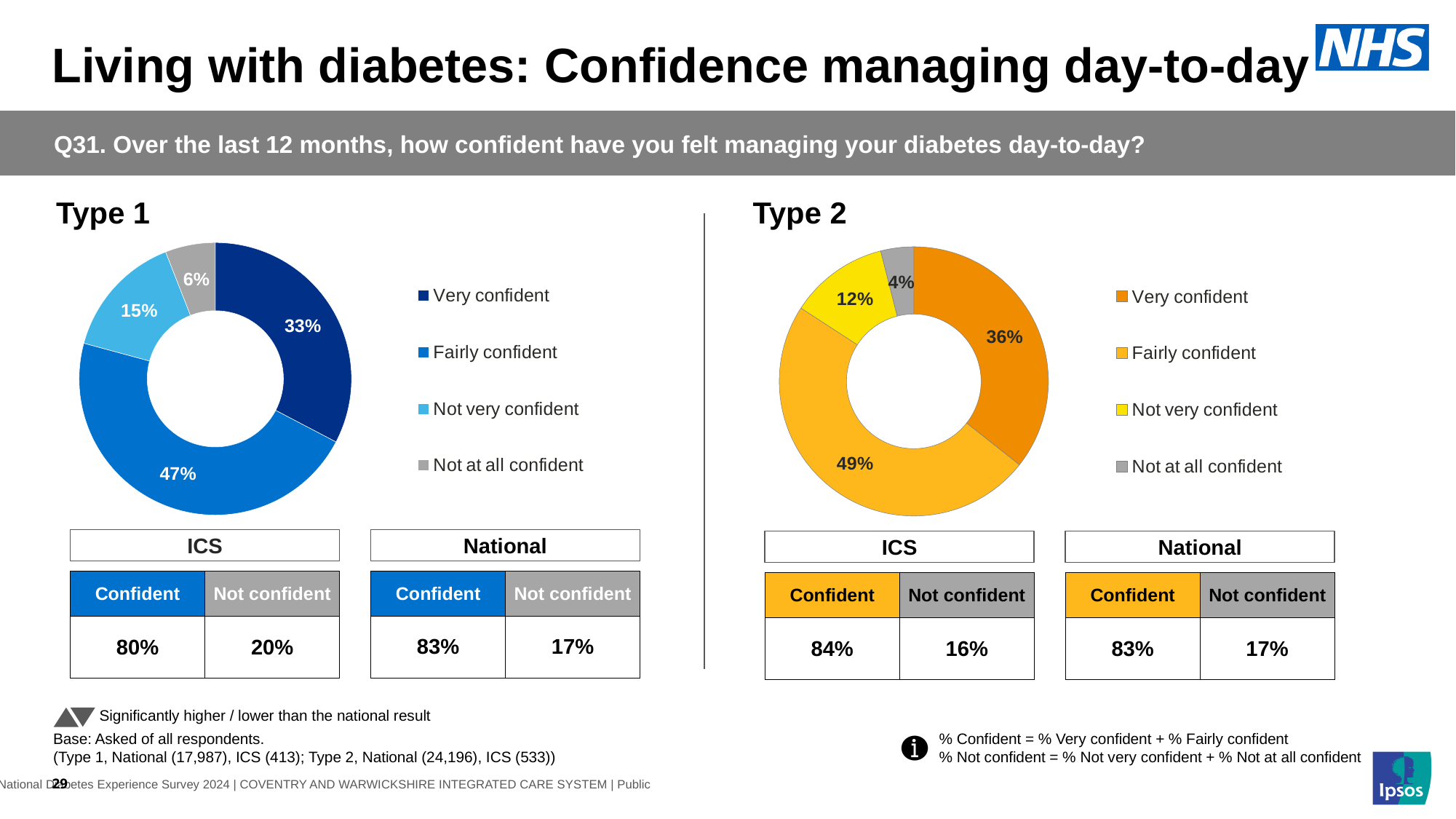
What kind of chart is used for Type 2? Doughnut (pie) chart In the Type 2 chart, what percentage of respondents were not very confident? 12% What colour represents 'Not at all confident' in the Type 2 chart? Grey In the Type 1 chart, what percentage of respondents were very confident? 33% In the Type 2 chart, which category has the smallest share? Not at all confident In the Type 1 chart, what is the combined share of not very confident and not at all confident? 21% In the Type 1 chart, which category has the largest share? Fairly confident In the Type 1 chart, what is the difference between the fairly confident and very confident shares? 14 percentage points In the Type 1 chart, what percentage of respondents were not at all confident? 6% In the Type 2 chart, which is larger: the very confident share or the not very confident share? Very confident In the Type 2 chart, what percentage of respondents were fairly confident? 49% How many categories does the Type 1 chart show? 4